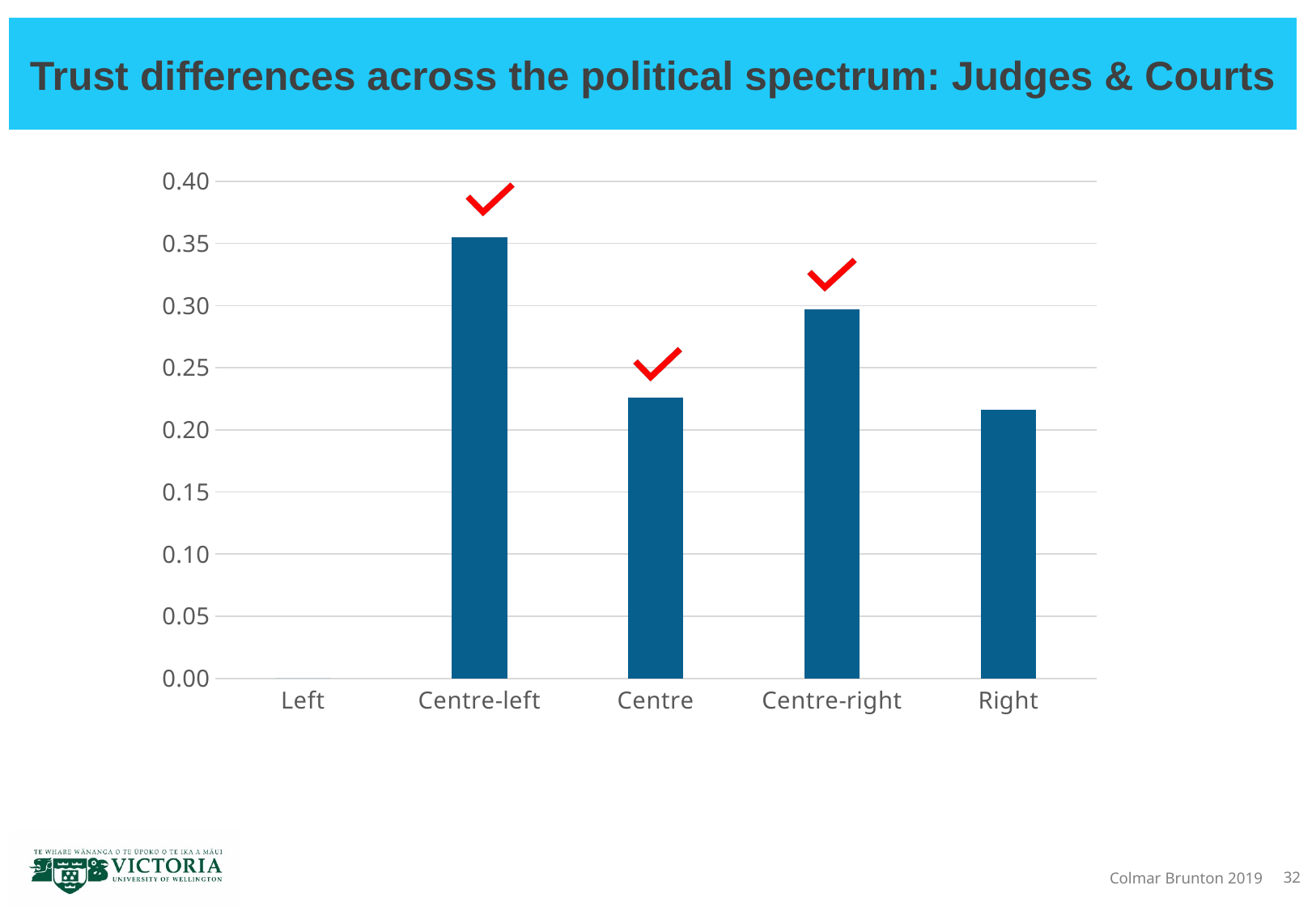
Which is larger, the value for Centre-right or the value for Centre? Centre-right What kind of chart is shown on the slide? Bar chart Is the value for Centre-left greater or less than 0.30? greater Is the value for Right greater or less than 0.20? greater Which is larger, the value for Centre-left or the value for Centre-right? Centre-left How many political categories are shown on the x axis? 5 Which category has the highest bar? Centre-left How many red check marks are shown above the bars? 3 Which category has the lowest value on the chart? Left Is the value for Centre-right greater or less than 0.25? greater What is the value shown for Left? 0.00